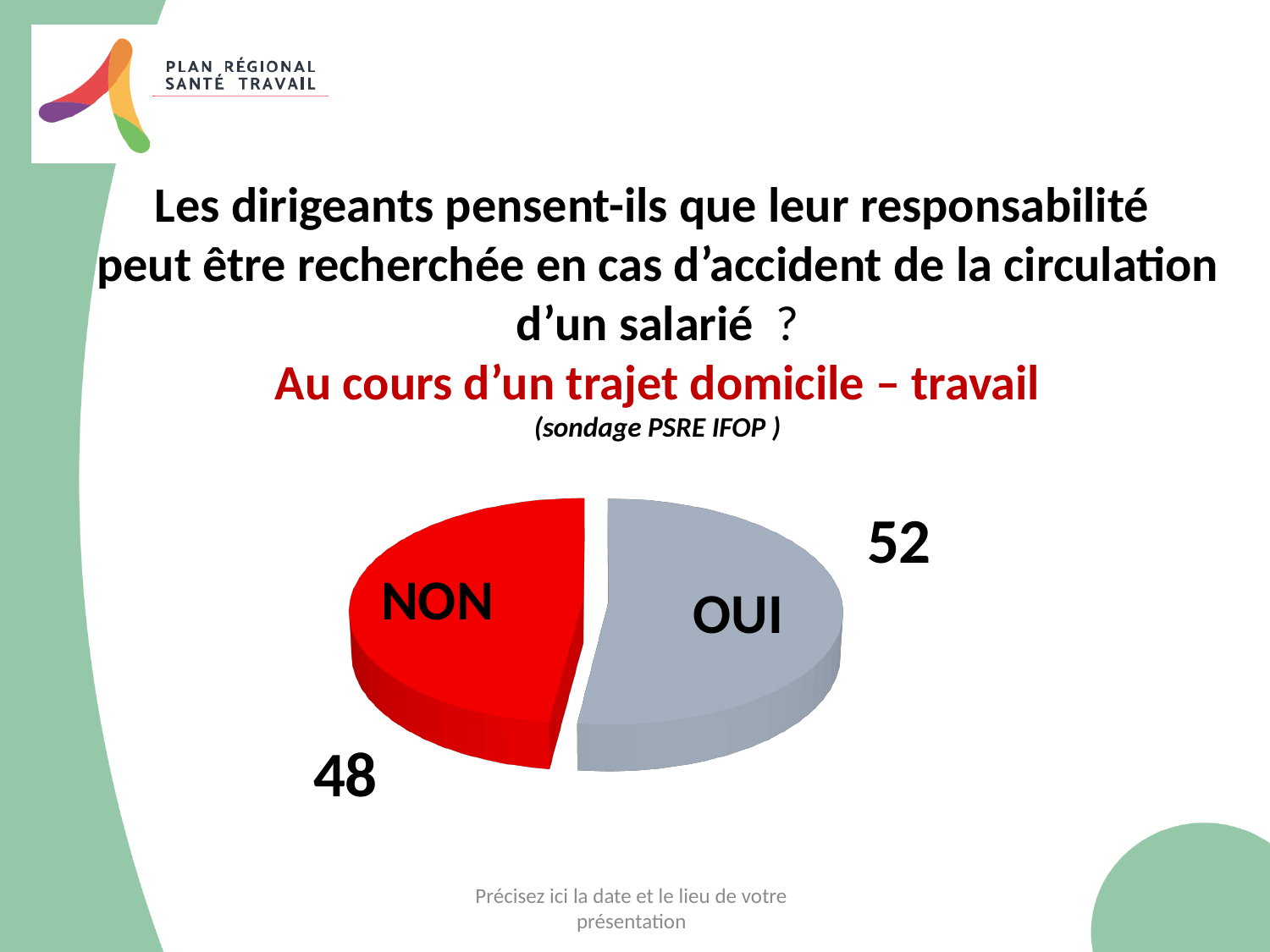
Which slice is the smallest? NON What is the difference between the OUI and NON values? 4 Which is larger, OUI or NON? OUI What colour is the NON slice? red What is the value for OUI? 52 How many slices does the pie chart have? 2 What is the value for NON? 48 Which slice is the largest? OUI What colour is the OUI slice? grey What kind of chart is shown on the slide? pie chart What is the total of the two slice values? 100